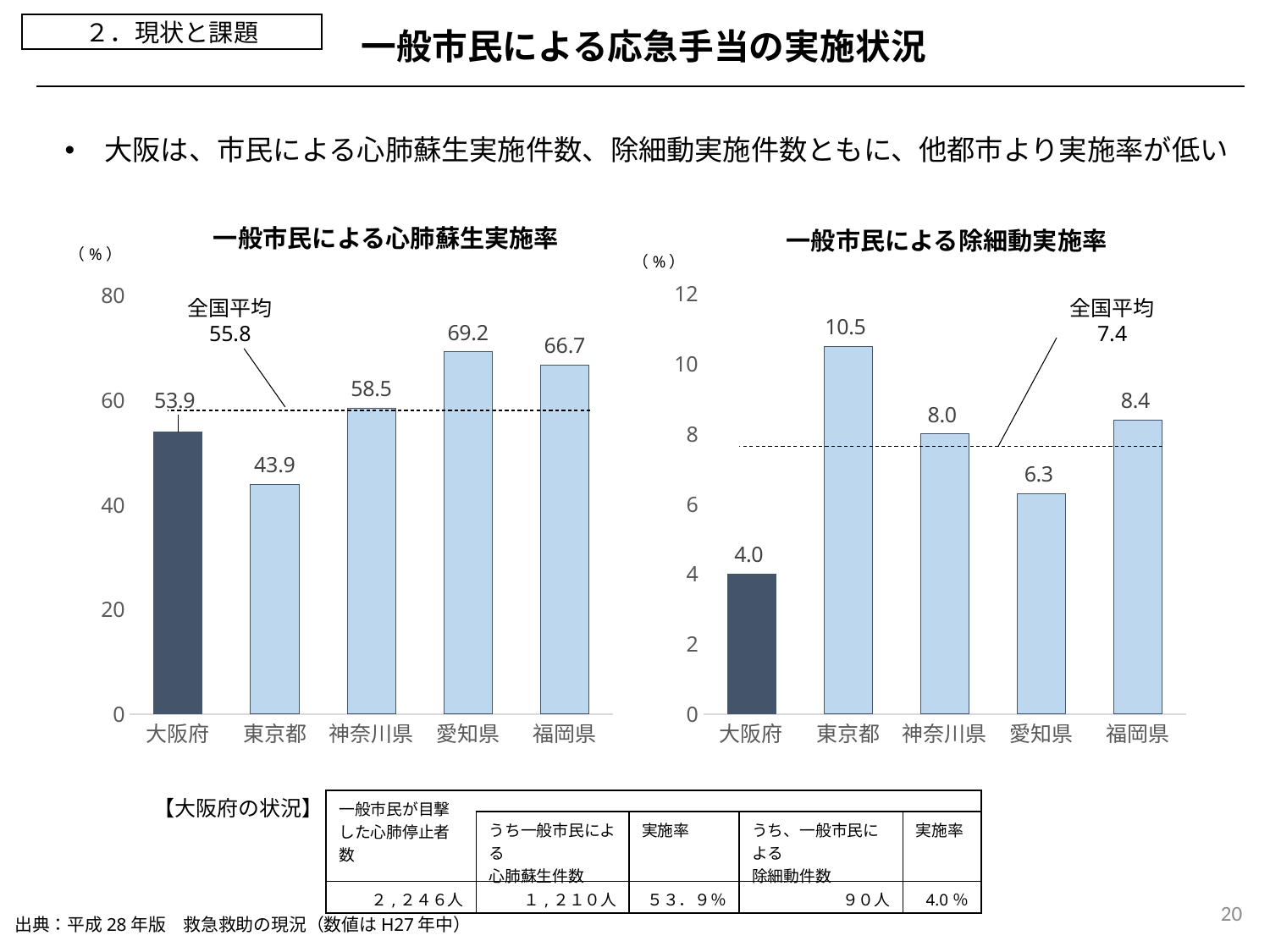
In the chart titled 一般市民による心肺蘇生実施率, what is the national average (全国平均) shown? 55.8 In the chart titled 一般市民による除細動実施率, what is the value for 東京都? 10.5 How many prefectures are shown in the chart titled 一般市民による心肺蘇生実施率? 5 In the chart titled 一般市民による除細動実施率, which prefecture has the lowest value? 大阪府 In the chart titled 一般市民による除細動実施率, what is the difference between the values for 東京都 and 大阪府? 6.5 In the chart titled 一般市民による心肺蘇生実施率, what is the difference between the values for 愛知県 and 東京都? 25.3 In the chart titled 一般市民による心肺蘇生実施率, which prefecture has the highest value? 愛知県 In the chart titled 一般市民による除細動実施率, which is larger, the value for 神奈川県 or the value for 福岡県? 福岡県 In the chart titled 一般市民による除細動実施率, is the value for 愛知県 greater or less than 8? less What kind of chart is the chart titled 一般市民による除細動実施率? bar chart In the chart titled 一般市民による心肺蘇生実施率, which prefecture has the lowest value? 東京都 In the chart titled 一般市民による心肺蘇生実施率, what is the value for 大阪府? 53.9